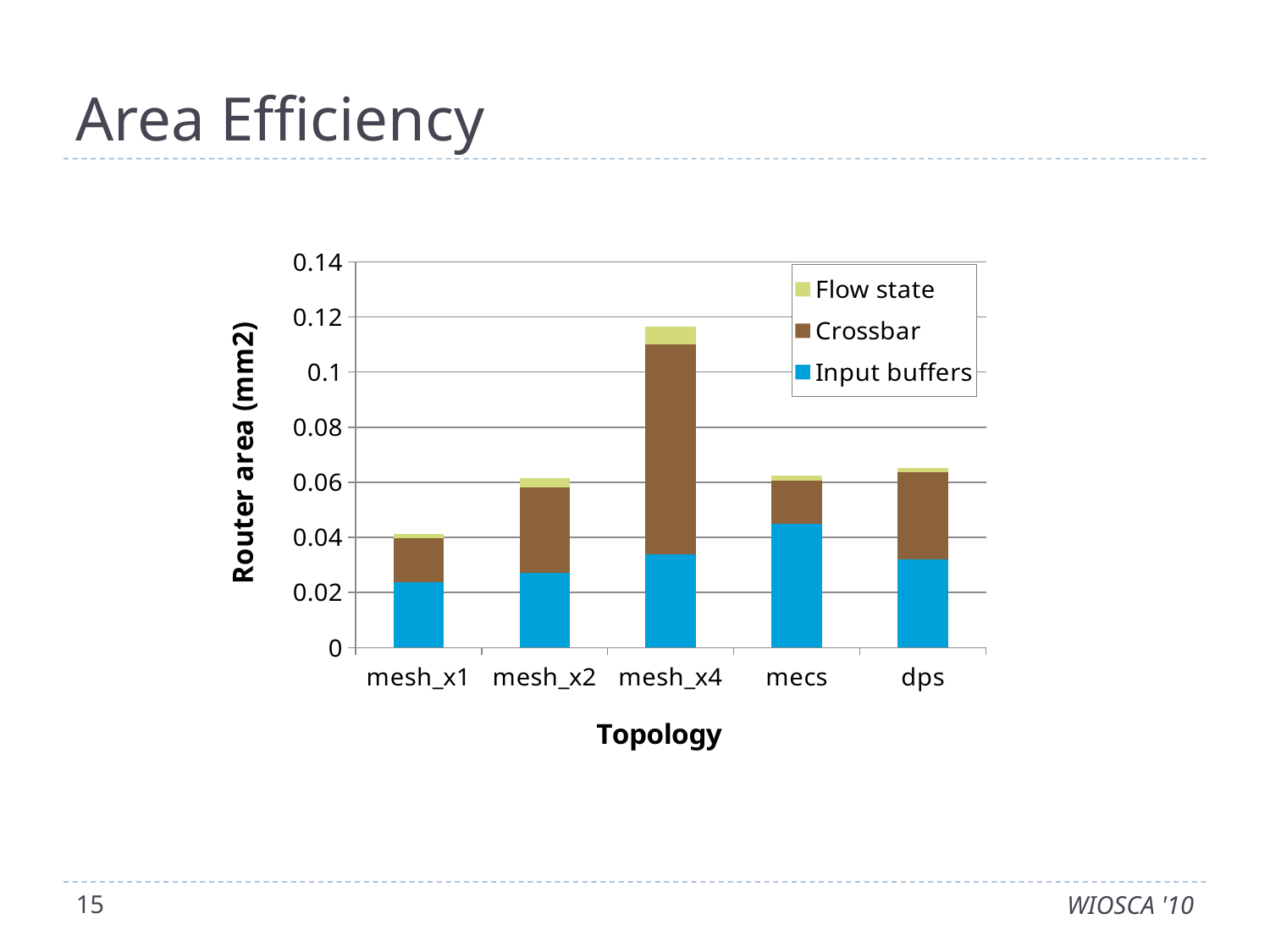
Is the total router area for mesh_x1 greater or less than 0.06? less Which has a larger total router area, mesh_x4 or dps? mesh_x4 Which topology has the largest Input buffers area? mecs What is the label of the y axis? Router area (mm2) Is the total router area for mesh_x4 greater or less than 0.1? greater How many series does the legend list? 3 How many topologies are shown on the x axis? 5 Is the Input buffers area for mecs greater or less than 0.04? greater What kind of chart is shown on the slide? stacked bar chart Which topology has the smallest total router area? mesh_x1 Which topology has the largest total router area? mesh_x4 Which topology has the largest Crossbar area? mesh_x4